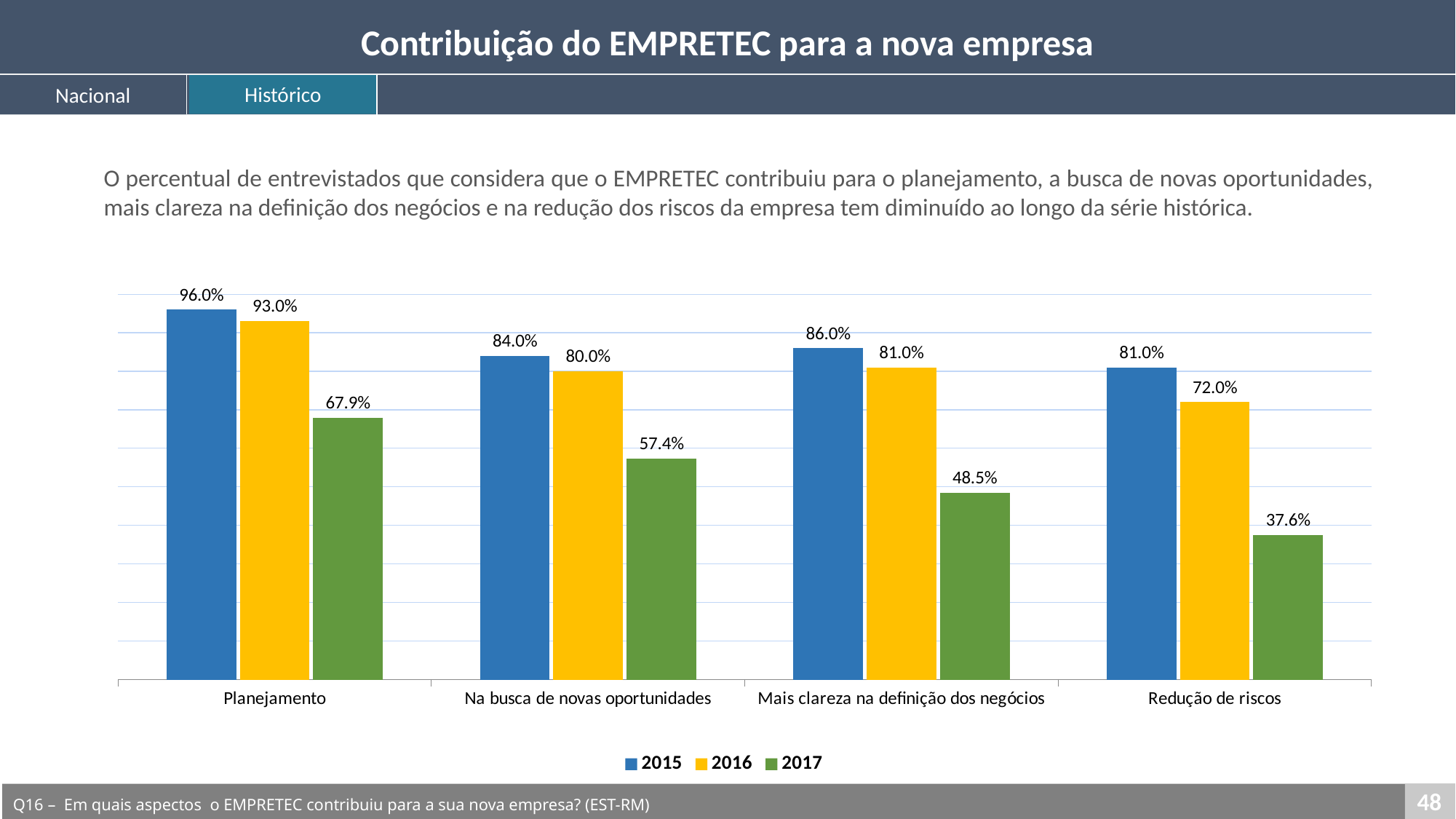
Which category has the lowest value for the 2016 series? Redução de riscos What is the difference between the 2015 and 2017 values in the Redução de riscos category? 43.4% What kind of chart is shown on the slide? Bar chart Which colour represents the 2017 series in the legend? Green Which category has the highest value for the 2017 series? Planejamento What is the value for 2016 in the Mais clareza na definição dos negócios category? 81.0% How many series does the legend list? 3 Which is larger: the 2016 value for Na busca de novas oportunidades or the 2016 value for Redução de riscos? Na busca de novas oportunidades How many categories are shown on the x axis? 4 What is the value for 2015 in the Planejamento category? 96.0% Within the Planejamento category, do the values rise or fall from 2015 to 2017? Fall What is the value for 2017 in the Redução de riscos category? 37.6%